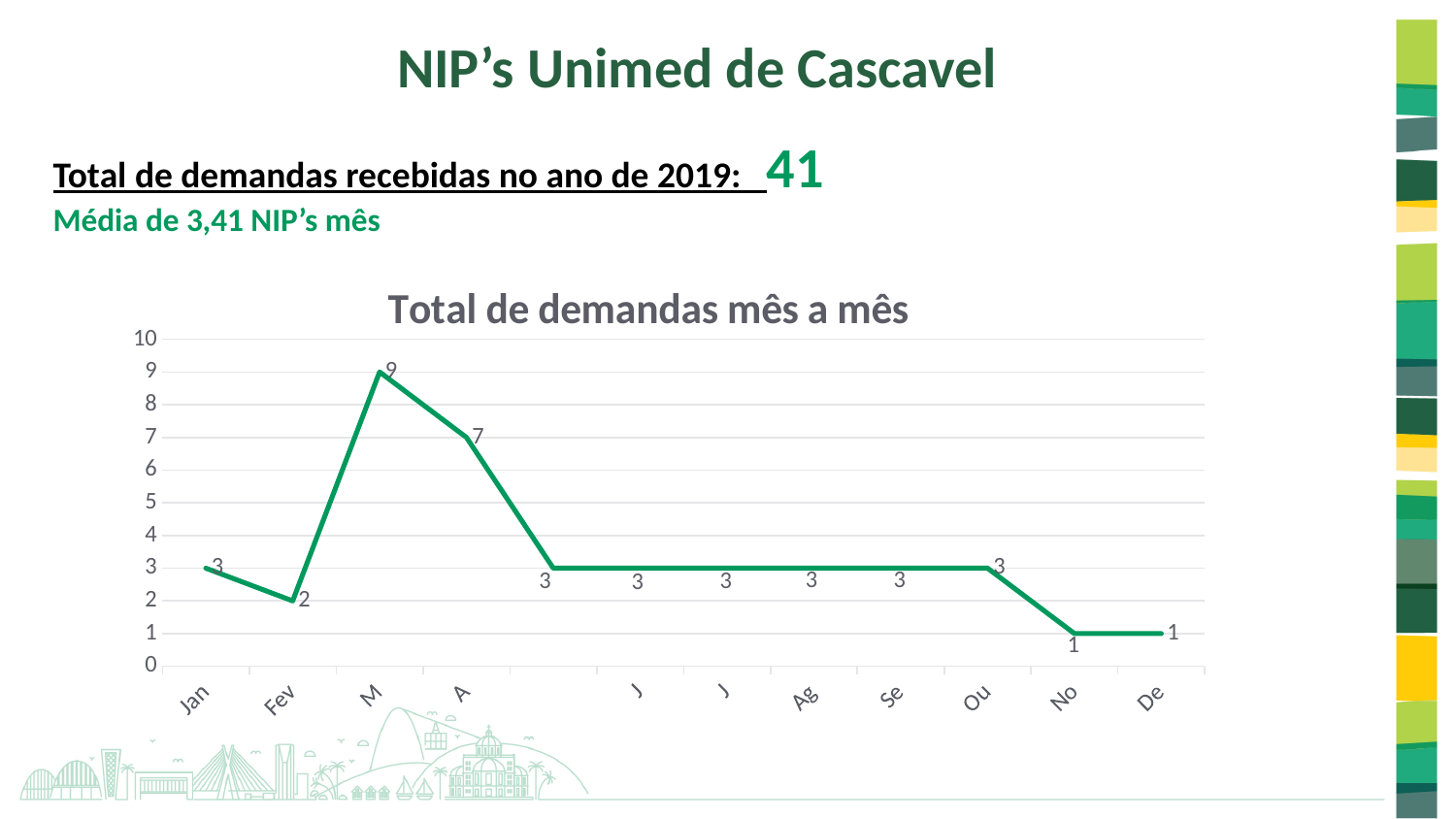
In the chart "Total de demandas mês a mês", what is the value for Ag? 3 In the chart "Total de demandas mês a mês", what is the difference between the values for M and A? 2 In the chart "Total de demandas mês a mês", is the value for A greater or less than 5? greater In the chart "Total de demandas mês a mês", what is the value for Jan? 3 In the chart "Total de demandas mês a mês", does the value rise or fall from Ou to No? fall In the chart "Total de demandas mês a mês", what is the highest value plotted? 9 How many data points are plotted in the chart "Total de demandas mês a mês"? 12 What type of chart is "Total de demandas mês a mês"? line chart In the chart "Total de demandas mês a mês", which is larger, the value for Jan or the value for Fev? Jan In the chart "Total de demandas mês a mês", which month has the highest value? M In the chart "Total de demandas mês a mês", what is the value for Fev? 2 In the chart "Total de demandas mês a mês", what is the value for De? 1